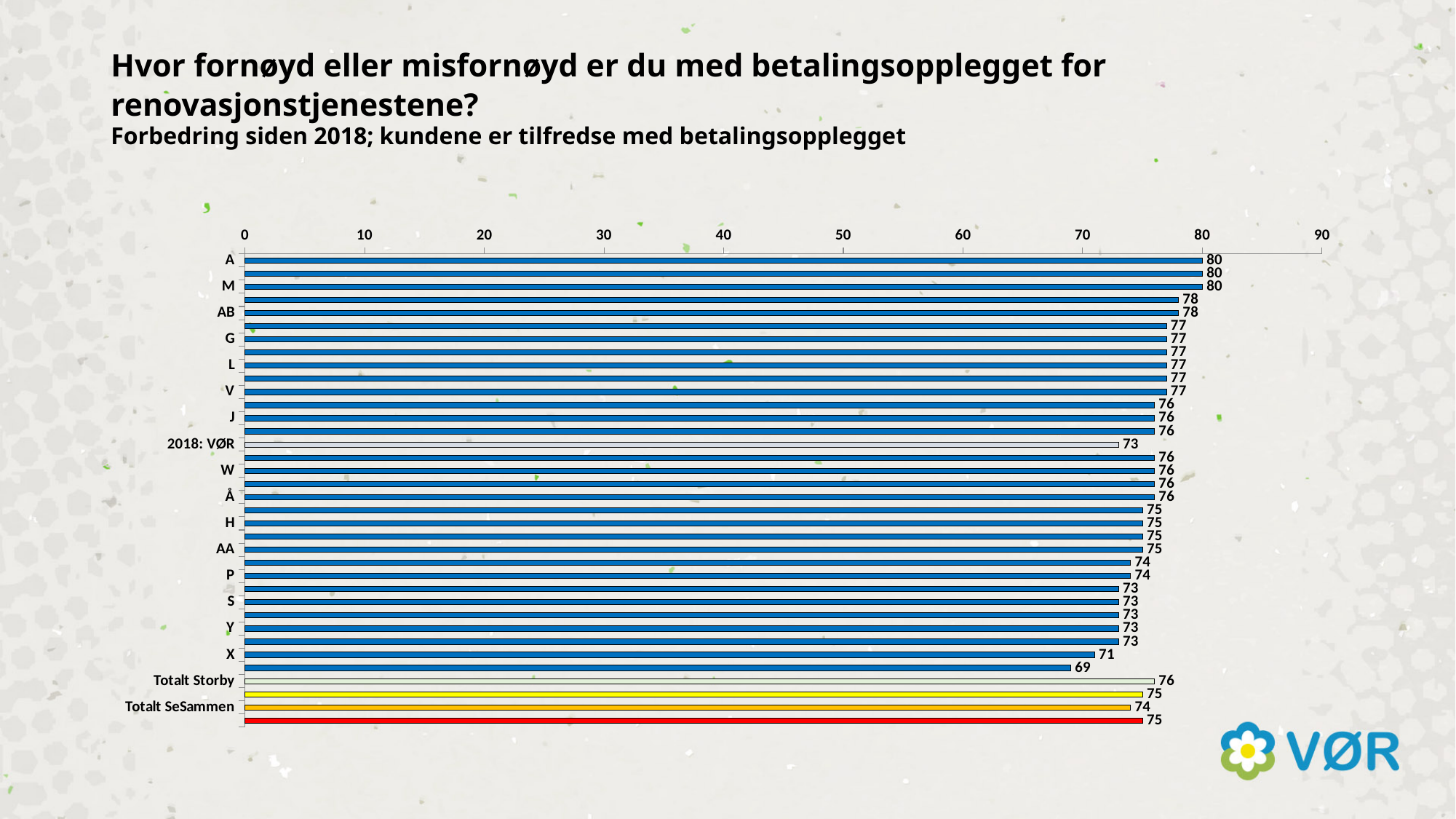
What is the value for AB? 78 What is the difference between the values for A and X? 9 What kind of chart is shown on the slide? bar chart Which has the larger value, A or X? A What is the value for A? 80 What colour is the bar for 2018: VØR? white Is the value for 2018: VØR greater or less than 80? less What is the value for Totalt SeSammen? 74 What is the value for Totalt Storby? 76 What is the value for X? 71 What is the value for 2018: VØR? 73 Do the values of the blue bars generally rise or fall going from the top of the chart (A) down to X? fall